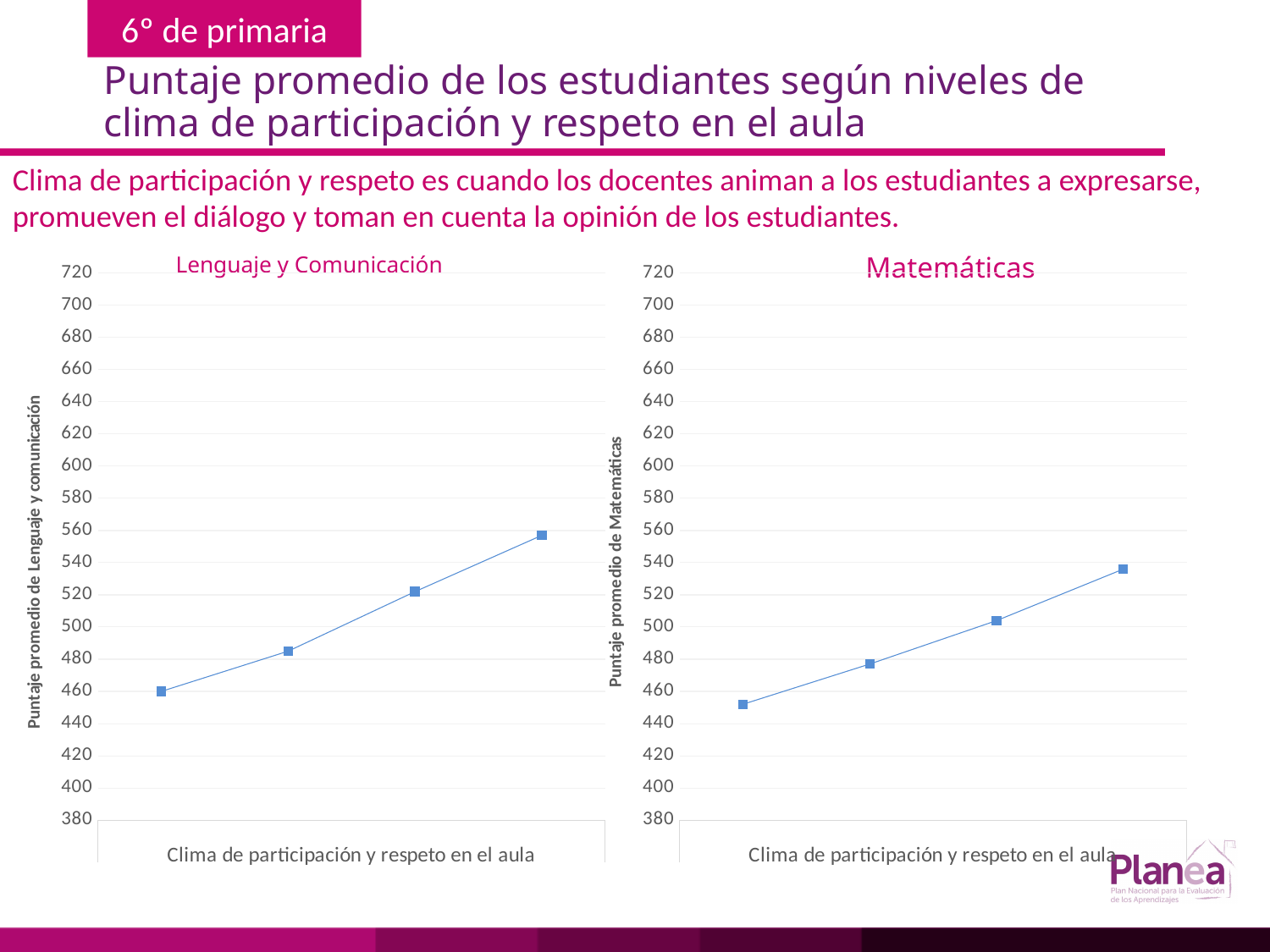
In the 'Lenguaje y Comunicación' chart, is the value of the rightmost point greater or less than 540? greater What type of chart is the 'Lenguaje y Comunicación' chart? Line chart In the 'Matemáticas' chart, is the value of the leftmost point greater or less than 460? less In the 'Matemáticas' chart, is the value of the rightmost point greater or less than 520? greater How many data points are plotted in the 'Matemáticas' chart? 4 Which chart has the higher rightmost point, 'Lenguaje y Comunicación' or 'Matemáticas'? Lenguaje y Comunicación In the 'Matemáticas' chart, do the values rise or fall from left to right along the x axis? Rise What is the y-axis title of the 'Matemáticas' chart? Puntaje promedio de Matemáticas What type of chart is the 'Matemáticas' chart? Line chart How many data points are plotted in the 'Lenguaje y Comunicación' chart? 4 In the 'Lenguaje y Comunicación' chart, do the values rise or fall from left to right along the x axis? Rise